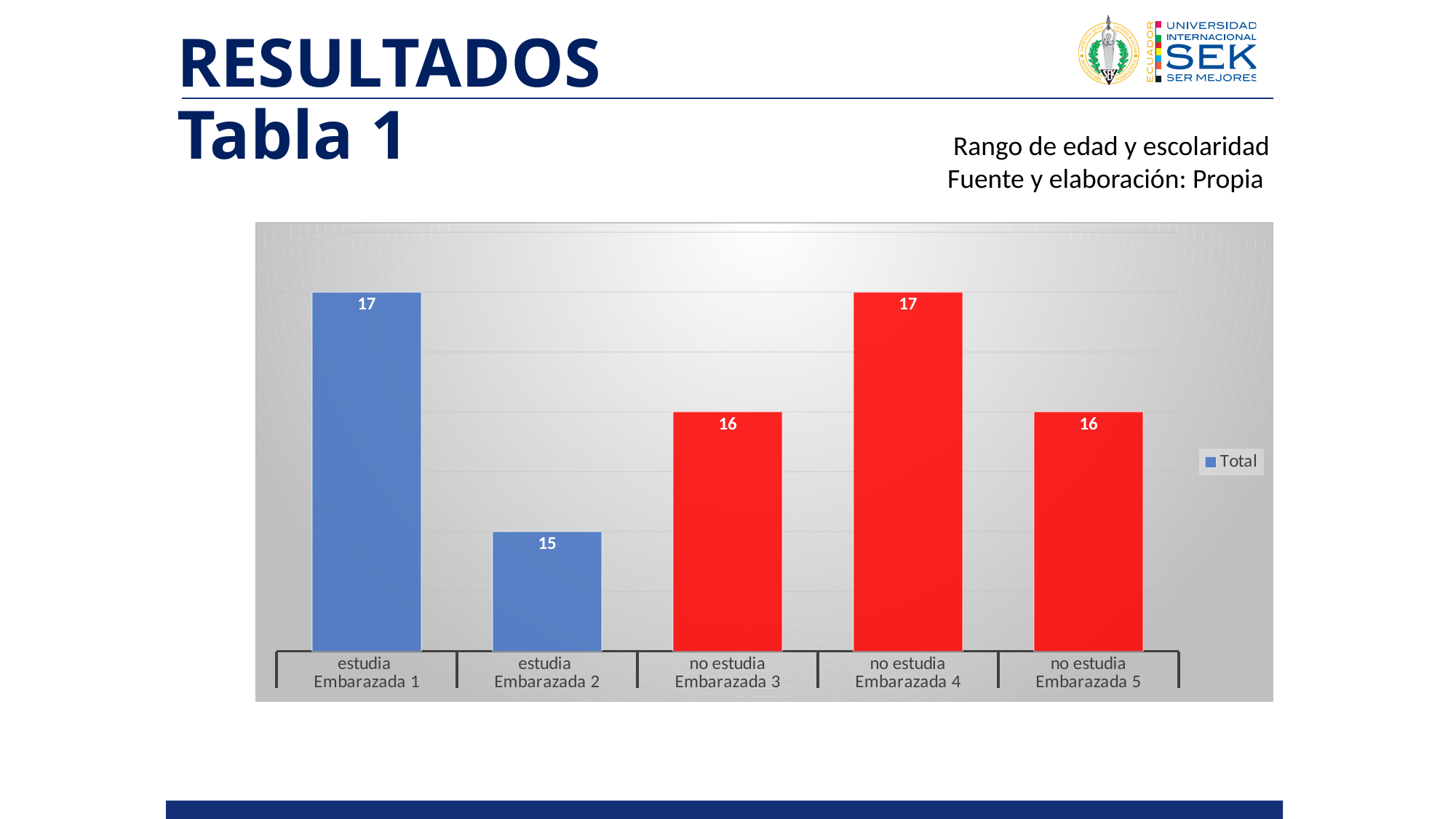
What is the value for 'no estudia Embarazada 3'? 16 What is the value for 'no estudia Embarazada 5'? 16 Which is larger, the value for 'no estudia Embarazada 4' or 'no estudia Embarazada 5'? no estudia Embarazada 4 What is the name of the series listed in the legend? Total What is the value for 'estudia Embarazada 1'? 17 How many categories are shown on the x axis? 5 What is the difference between the values for 'estudia Embarazada 1' and 'estudia Embarazada 2'? 2 What is the value for 'estudia Embarazada 2'? 15 Which category has the lowest value? estudia Embarazada 2 How many series does the legend list? 1 What is the difference between the values for 'no estudia Embarazada 4' and 'no estudia Embarazada 3'? 1 What kind of chart is shown on the slide? bar chart